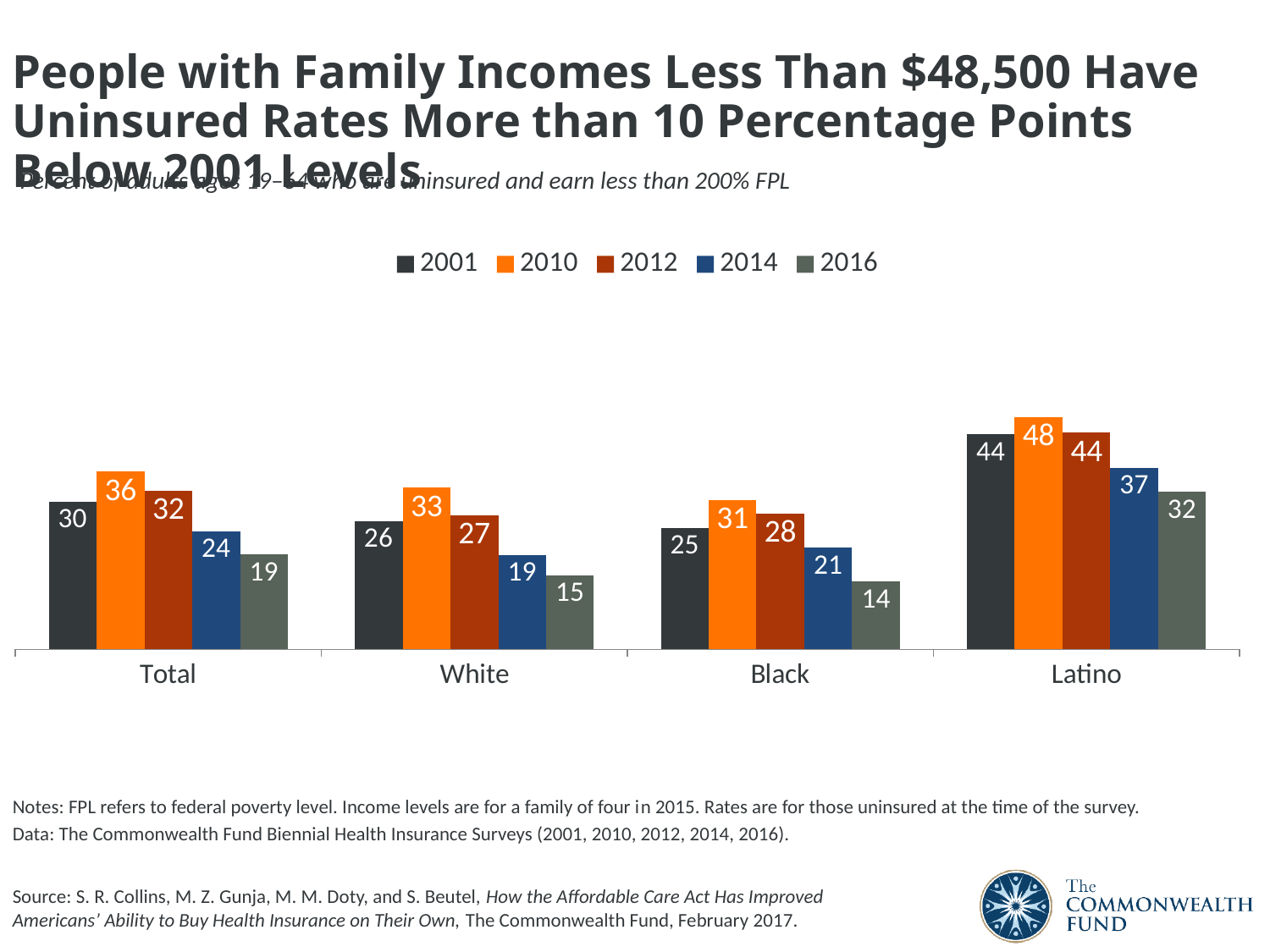
What is the difference between the 2001 and 2016 values for Total? 11 What is the difference between the 2010 and 2016 values for Latino? 16 How many categories are shown on the x axis? 4 What is the value for Latino in 2016? 32 What is the value for White in 2010? 33 How many series does the legend list? 5 Which is larger, the 2012 value for White or the 2012 value for Black? Black Which category has the lowest value in 2016? Black What is the value for Black in 2014? 21 What kind of chart is shown on the slide? Bar chart Which series is shown in orange in the legend? 2010 Which category has the highest value in 2001? Latino